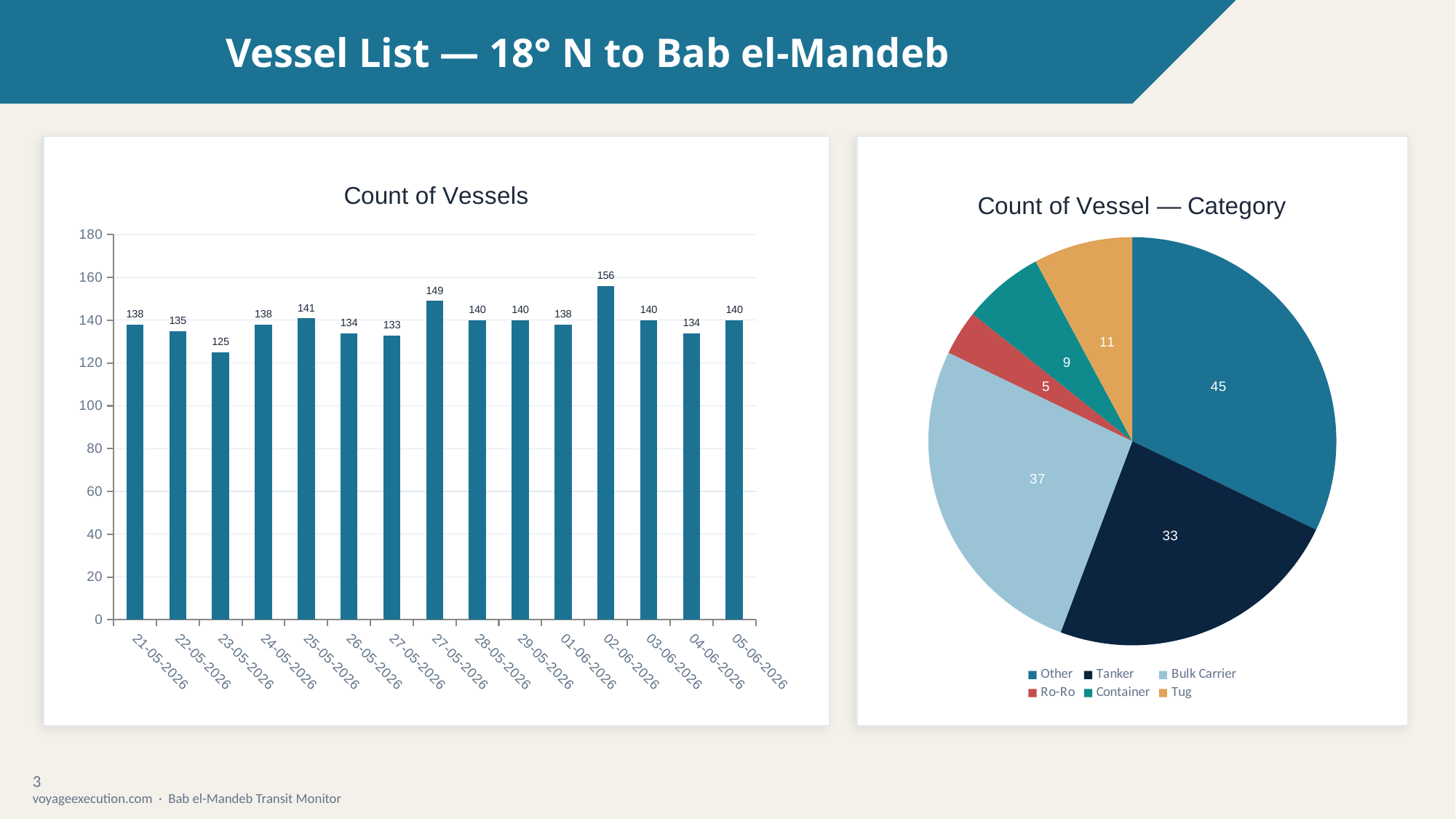
In the Count of Vessels bar chart, which date has the highest count? 02-06-2026 In the Count of Vessels bar chart, what is the value for 02-06-2026? 156 In the Count of Vessel — Category pie chart, what is the difference between the Other and Tanker values? 12 How many bars are plotted in the Count of Vessels bar chart? 15 What kind of chart is the Count of Vessels chart on the left? Bar chart In the Count of Vessels bar chart, which date has the lowest count? 23-05-2026 In the Count of Vessel — Category pie chart, what is the value for Bulk Carrier? 37 In the Count of Vessels bar chart, what is the value for 23-05-2026? 125 In the Count of Vessels bar chart, what is the difference between the values for 02-06-2026 and 23-05-2026? 31 In the Count of Vessel — Category pie chart, which category has the smallest slice? Ro-Ro In the Count of Vessels bar chart, which is larger: the value for 25-05-2026 or the value for 26-05-2026? 25-05-2026 How many categories does the legend of the Count of Vessel — Category pie chart list? 6